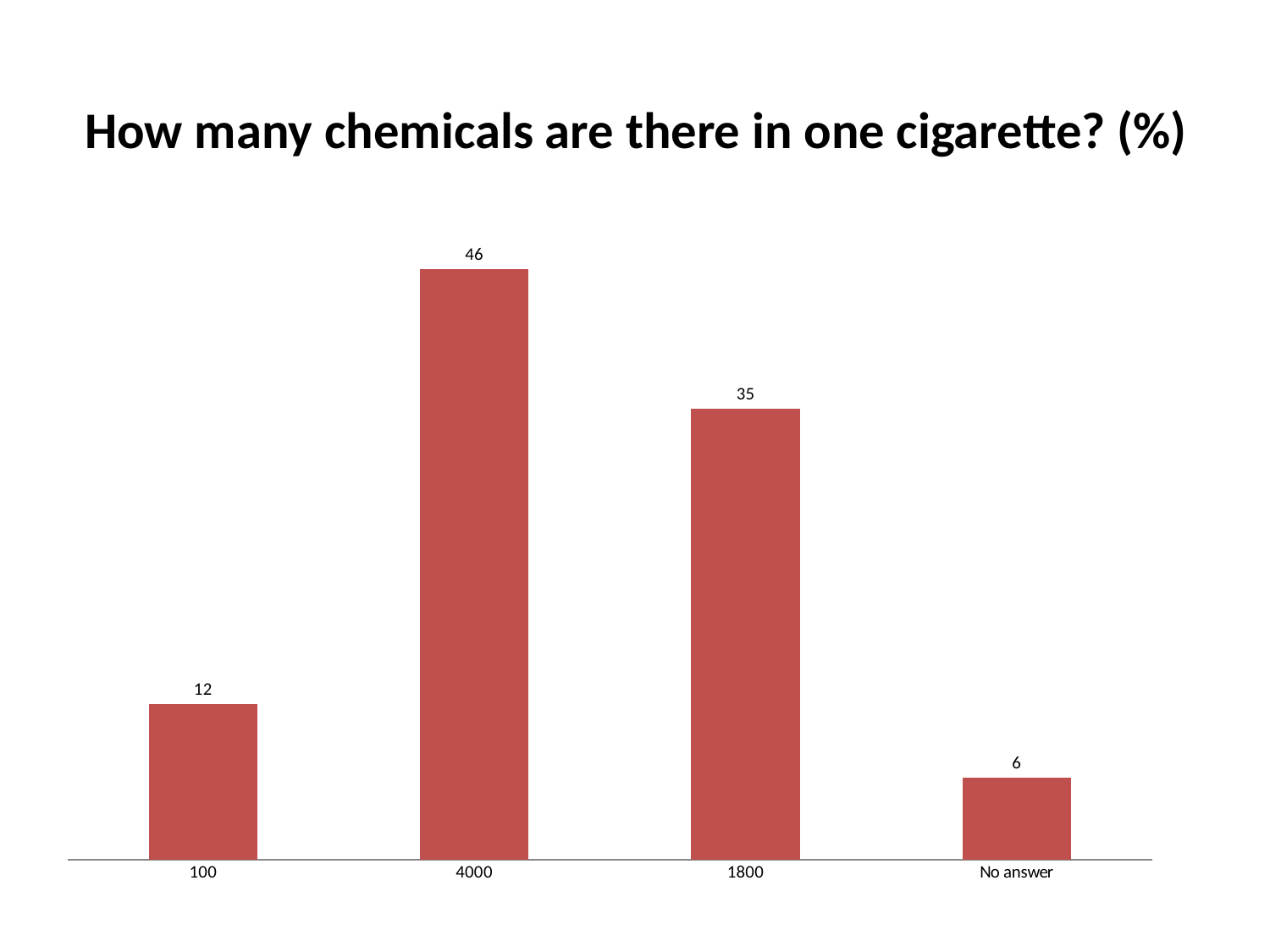
Which category has the lowest value? No answer What is the difference between the values for 100 and No answer? 6 What is the value for the 100 category? 12 Which category has the highest value? 4000 What kind of chart is shown on the slide? Bar chart What is the title of the chart? How many chemicals are there in one cigarette? (%) Which is larger, the value for 100 or the value for 1800? 1800 What is the value for the 1800 category? 35 How many categories are shown on the x axis? 4 What is the value for No answer? 6 What percentage of respondents answered 4000? 46 What is the difference between the values for 4000 and 1800? 11